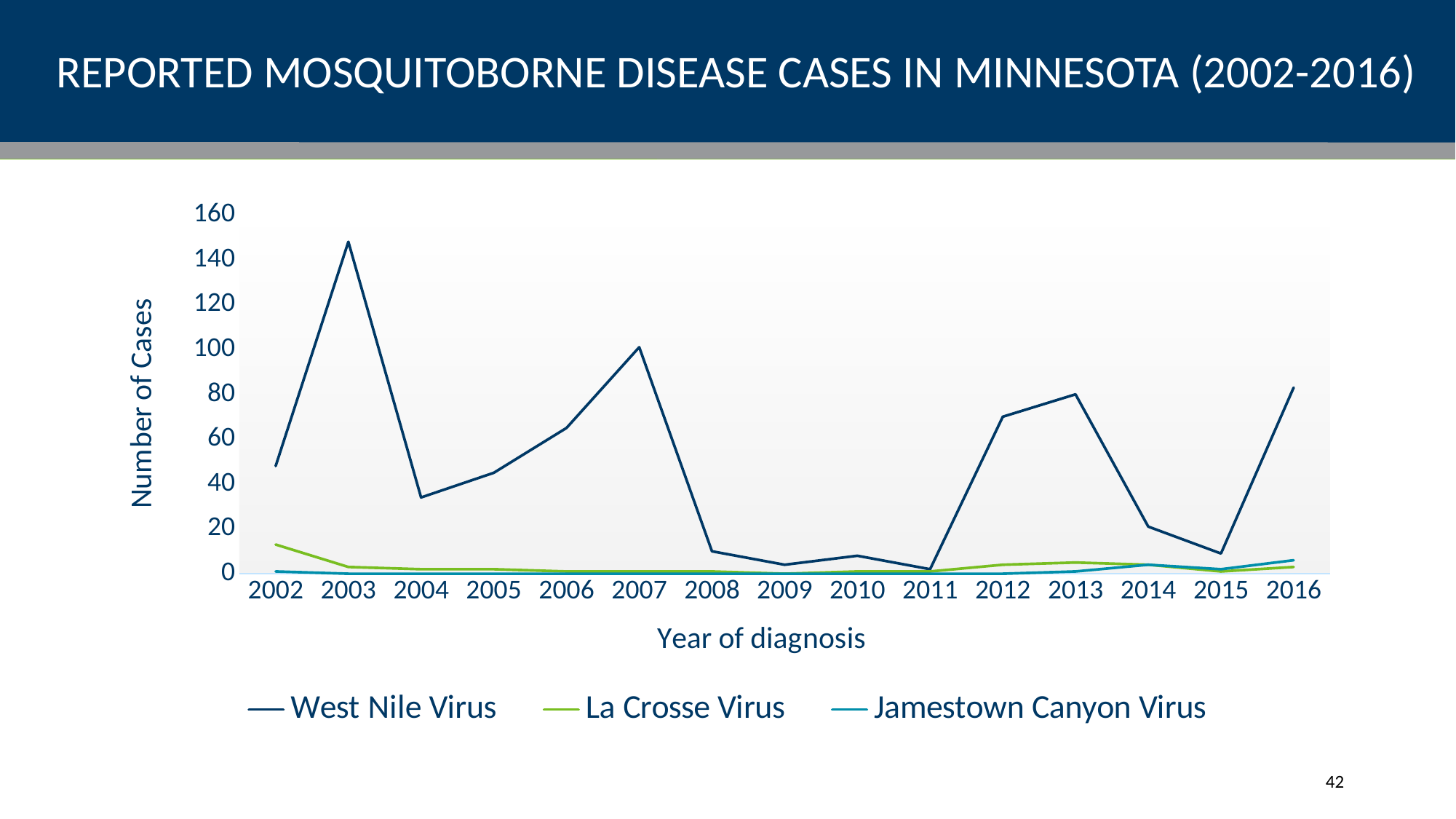
Did West Nile Virus cases rise or fall from 2015 to 2016? rise In which year did West Nile Virus have the highest number of reported cases? 2003 What kind of chart is shown on the slide? line chart Is the number of West Nile Virus cases in 2008 greater or less than 20? less Which had more reported West Nile Virus cases, 2003 or 2007? 2003 How many series does the legend list? 3 Is the number of West Nile Virus cases in 2004 greater or less than 40? less What is the label on the y axis of the chart? Number of Cases Did West Nile Virus cases rise or fall from 2007 to 2008? fall Is the number of West Nile Virus cases in 2012 greater or less than 60? greater How many years are plotted along the x axis? 15